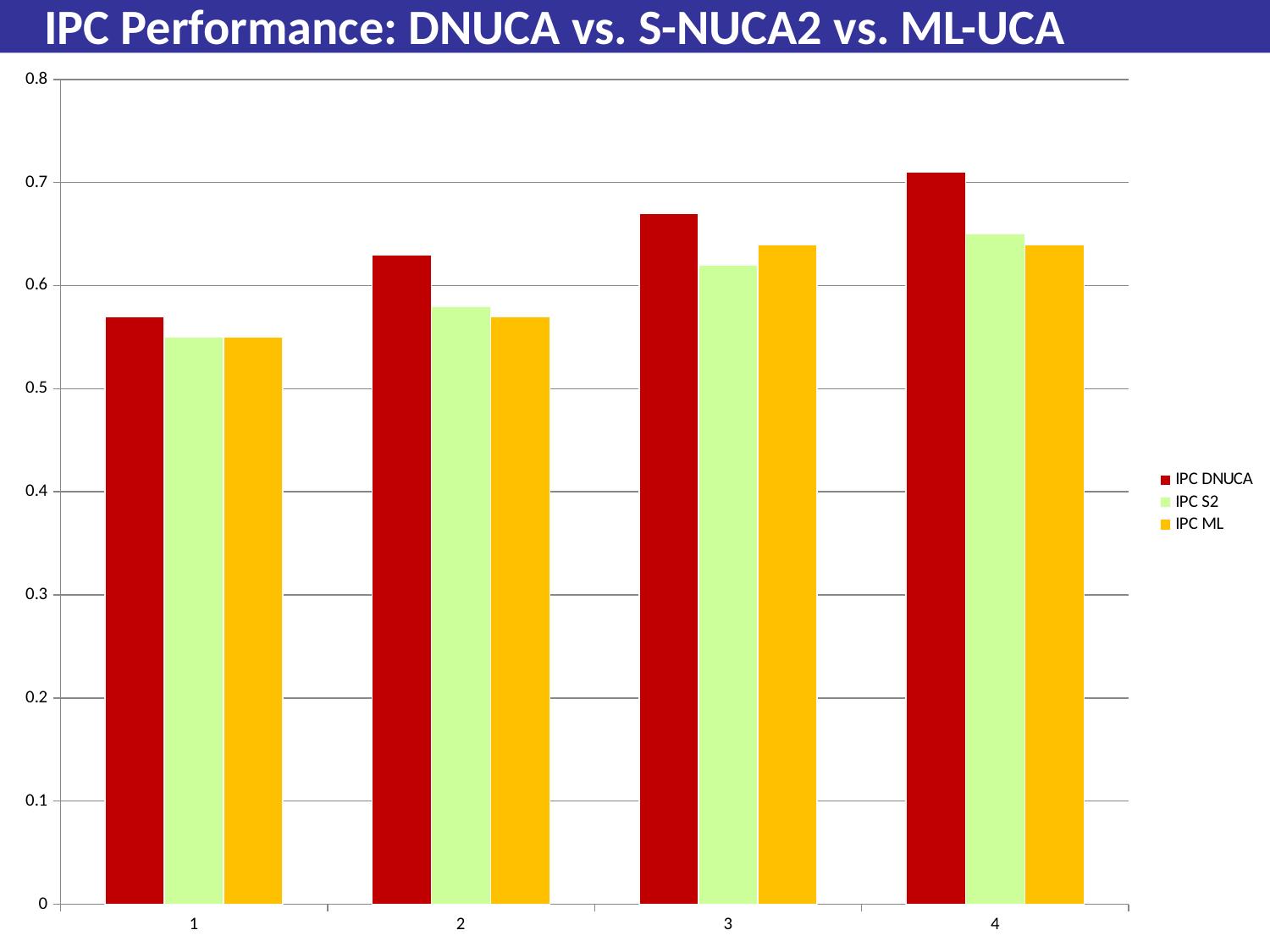
Is the IPC DNUCA value for category 3 greater or less than 0.7? less How many series does the legend list? 3 What is the title of the chart? IPC Performance: DNUCA vs. S-NUCA2 vs. ML-UCA Is the IPC DNUCA value for category 1 greater or less than 0.5? greater How many categories are shown on the x axis? 4 Is the IPC ML value for category 3 greater or less than 0.6? greater Which category has the lowest IPC DNUCA value? 1 What kind of chart is shown on the slide? bar chart Do the IPC DNUCA values rise or fall from category 1 to category 4? rise For category 2, which is larger: IPC DNUCA or IPC S2? IPC DNUCA Which category has the highest IPC DNUCA value? 4